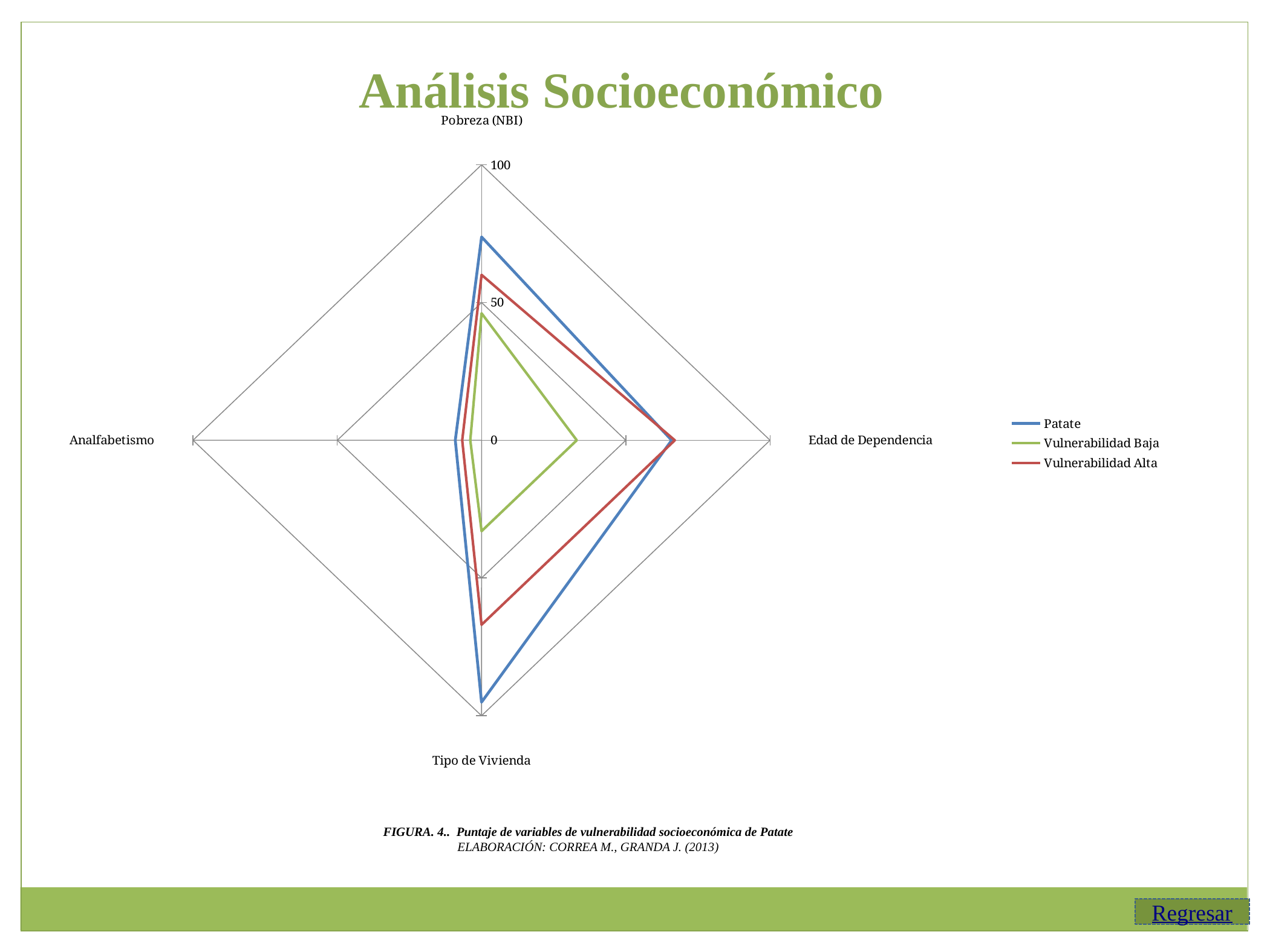
Is the Vulnerabilidad Baja value for Edad de Dependencia greater or less than 50? less What kind of chart is shown on the slide? Radar chart For Pobreza (NBI), which is larger: the Patate value or the Vulnerabilidad Baja value? Patate How many variables (axes) does the radar chart have? 4 Is the Vulnerabilidad Alta value for Tipo de Vivienda greater or less than 50? greater Is the Patate value for Analfabetismo greater or less than 50? less How many series does the legend list? 3 On which variable does the Patate series reach its highest value? Tipo de Vivienda Which series is drawn in red in the chart? Vulnerabilidad Alta For Tipo de Vivienda, which is larger: the Vulnerabilidad Alta value or the Vulnerabilidad Baja value? Vulnerabilidad Alta